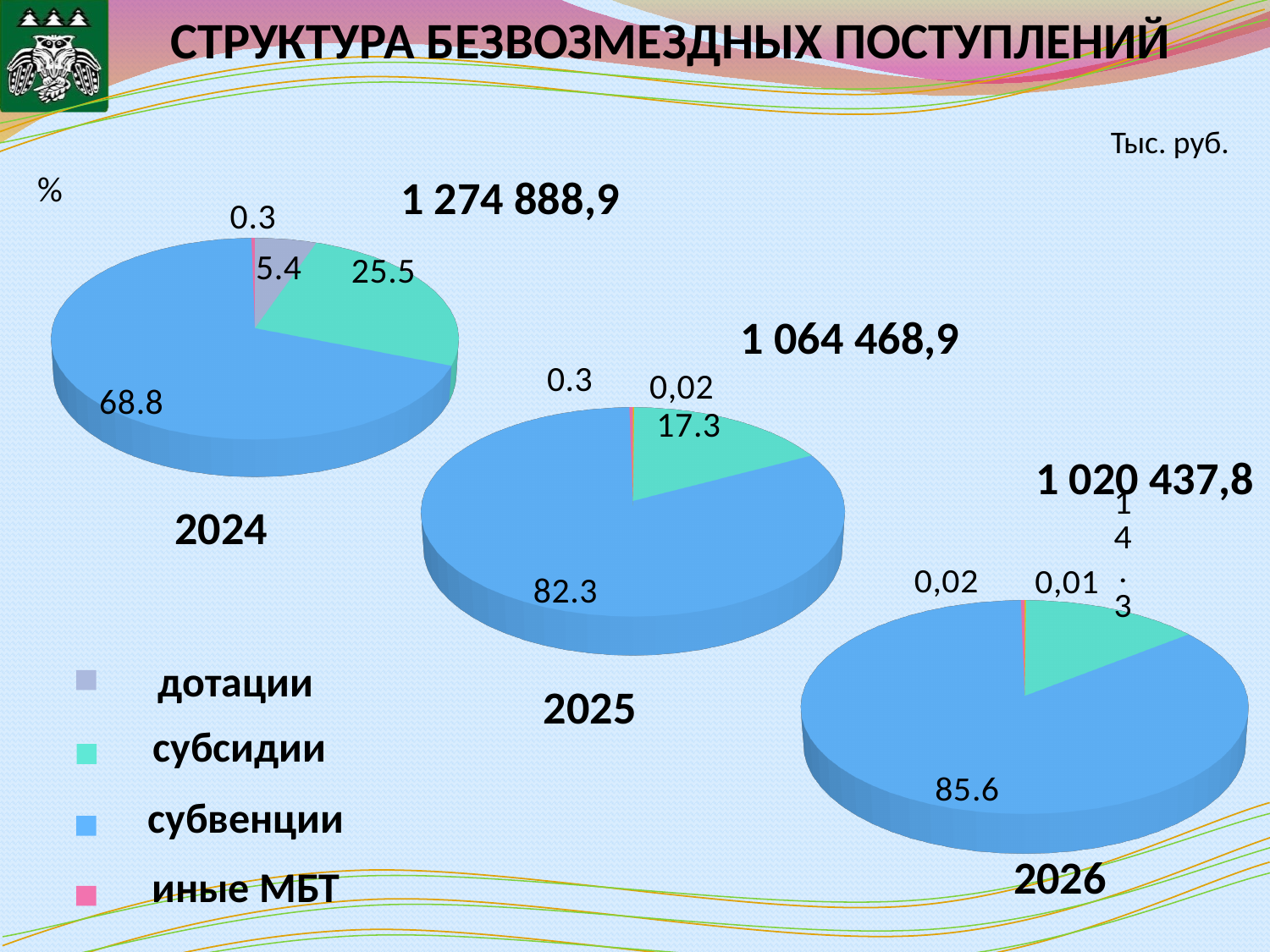
In the 2024 pie chart, what is the difference between the shares of субвенции and субсидии? 43.3 In the 2026 pie chart, what is the share for субвенции? 85.6 In the 2026 pie chart, which category has the largest share? субвенции In the 2024 pie chart, what is the share for субсидии? 25.5 How many categories does the legend list? 4 What total amount (тыс. руб.) is shown above the 2025 pie chart? 1 064 468,9 In the 2025 pie chart, which is larger: the share of субвенции or the share of субсидии? субвенции How many pie charts are shown on the slide? 3 In the 2024 pie chart, what is the share for субвенции? 68.8 In the 2024 pie chart, what is the share for дотации? 5.4 What kind of chart is used on this slide? pie chart In the 2025 pie chart, what is the share for субвенции? 82.3